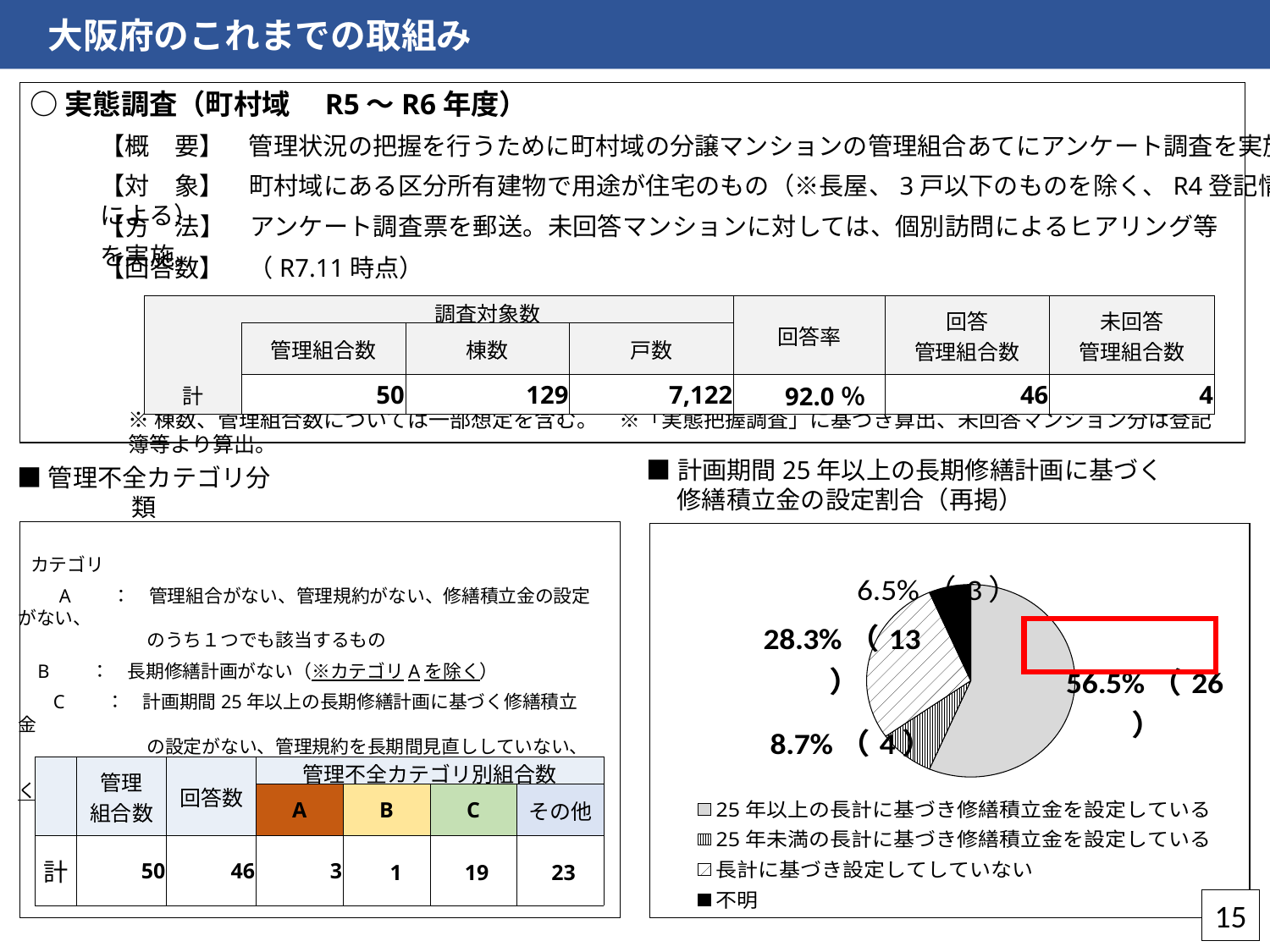
In the pie chart, what percentage share is shown for 不明? 6.5% How many slices does the pie chart have? 4 In the pie chart, what is the difference in percentage points between the 56.5% slice and the 28.3% slice? 28.2 What kind of chart is shown under the heading 計画期間25年以上の長期修繕計画に基づく修繕積立金の設定割合（再掲）? pie chart In the pie chart, what percentage share is shown for 25年以上の長計に基づき修繕積立金を設定している? 56.5% In the pie chart, what percentage share is shown for 長計に基づき設定してしていない? 28.3% Which slice of the pie chart is the smallest? 不明 Which slice of the pie chart is the largest? 25年以上の長計に基づき修繕積立金を設定している In the pie chart, what percentage share is shown for 25年未満の長計に基づき修繕積立金を設定している? 8.7% In the pie chart, which slice is larger: 25年未満の長計に基づき修繕積立金を設定している or 不明? 25年未満の長計に基づき修繕積立金を設定している In the pie chart, how many cases (the number in parentheses) are in the 25年以上の長計に基づき修繕積立金を設定している slice? 26 In the pie chart, how many cases (the number in parentheses) are in the 不明 slice? 3